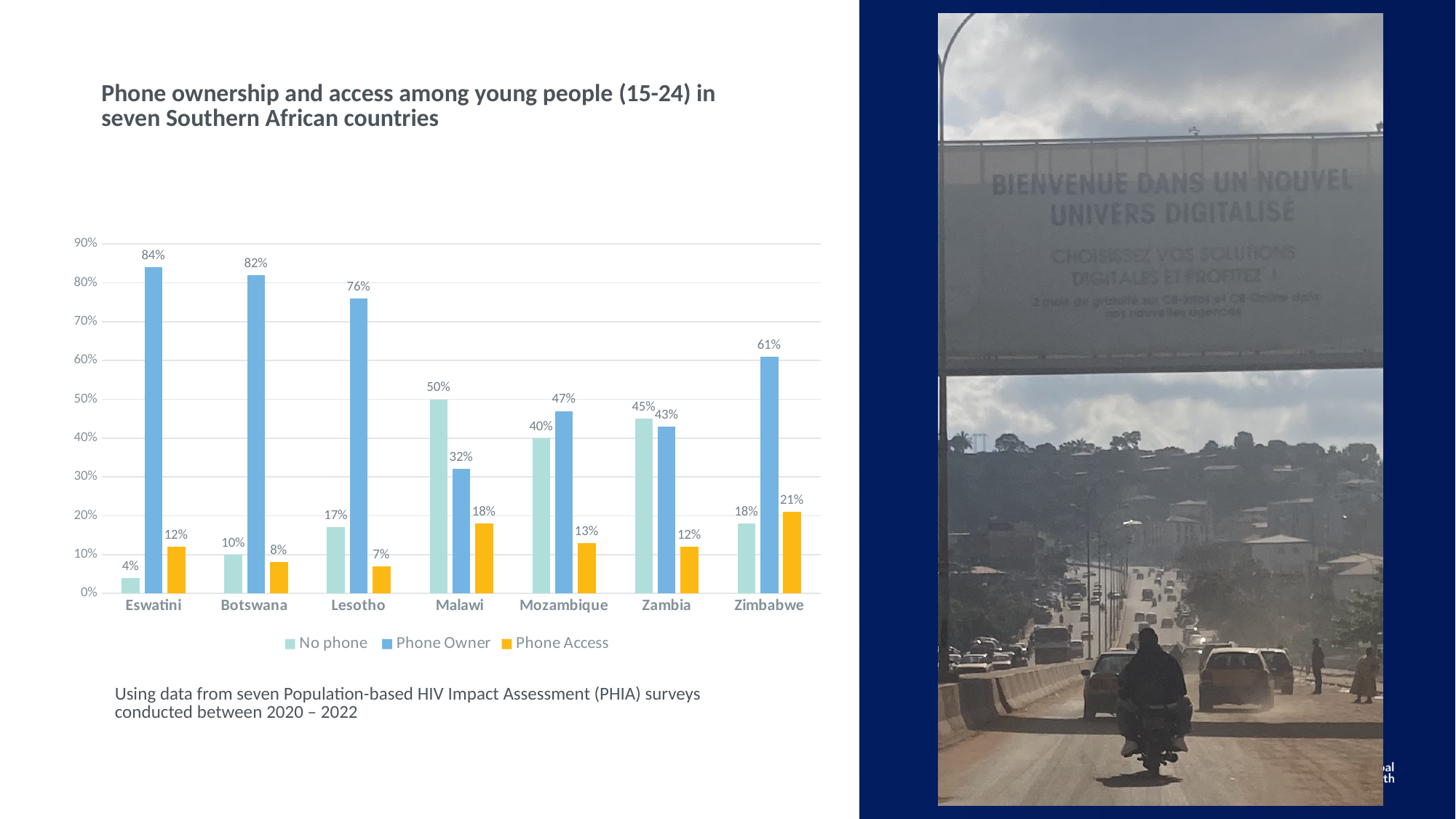
What is the title of the chart? Phone ownership and access among young people (15-24) in seven Southern African countries What is the No phone value for Malawi? 50% Which is larger for Malawi: the No phone value or the Phone Owner value? No phone What is the Phone Access value for Zimbabwe? 21% Which country has the lowest Phone Access value? Lesotho How many countries are shown on the x axis? 7 What kind of chart is shown on the slide? Bar chart Which country has the lowest No phone value? Eswatini What is the difference between the Phone Owner values for Botswana and Lesotho? 6% Which country has the highest Phone Owner value? Eswatini How many series does the legend list? 3 What is the Phone Owner value for Eswatini? 84%